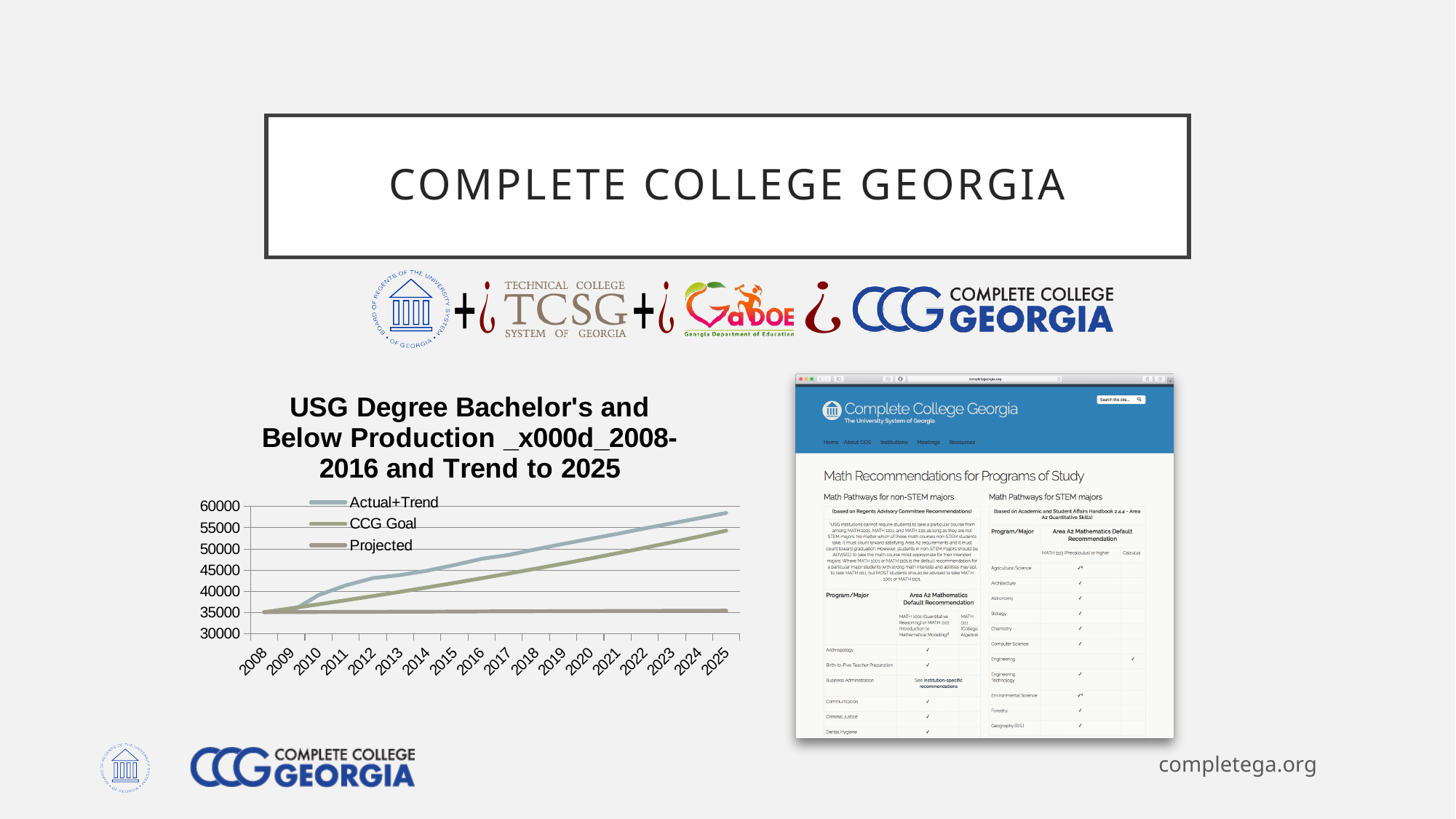
How many years are shown along the x axis of the chart? 18 Is the value for Actual+Trend in 2025 greater or less than 55000? greater How many series does the chart's legend list? 3 Is the value for CCG Goal in 2012 greater or less than 40000? less Which series has the higher value in 2020, CCG Goal or Projected? CCG Goal Is the value for Actual+Trend in 2013 greater or less than 40000? greater Which series has the higher value in 2025, Actual+Trend or CCG Goal? Actual+Trend What kind of chart is shown on the slide? line chart Does the Actual+Trend series rise or fall from 2008 to 2025? rise What are the three series named in the chart's legend? Actual+Trend, CCG Goal, Projected